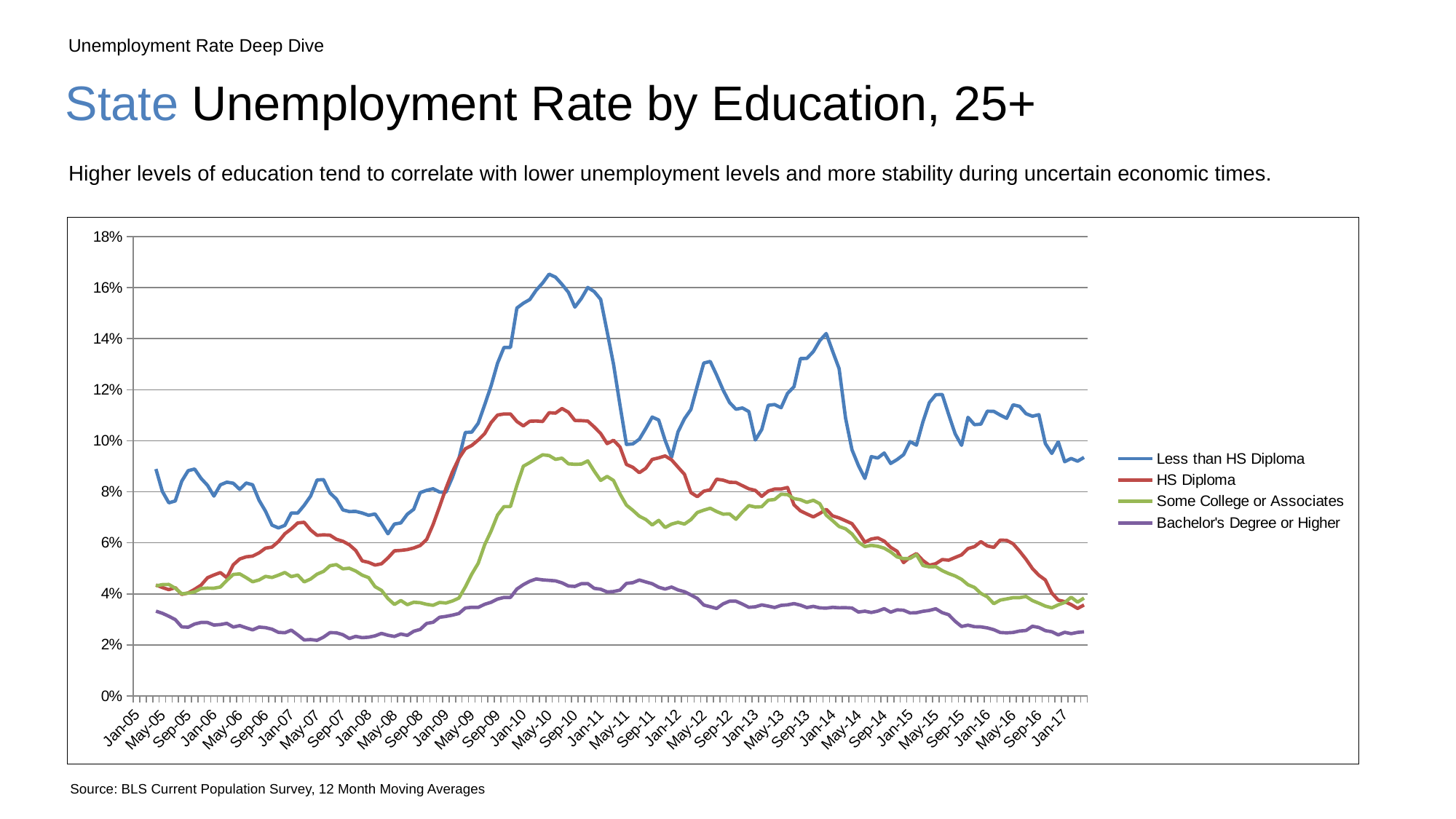
Is the peak value for Less than HS Diploma greater or less than 16%? greater Which education group has the lowest unemployment rate across the whole period? Bachelor's Degree or Higher Around Jan-14, which is higher: Less than HS Diploma or HS Diploma? Less than HS Diploma How many series does the legend list? 4 Is the highest value reached by Bachelor's Degree or Higher greater or less than 6%? less Between Jan-08 and May-10, does the Less than HS Diploma line rise or fall? rise Which series is drawn in purple? Bachelor's Degree or Higher Around Jan-17, is the value for Some College or Associates greater or less than 6%? less What kind of chart is shown on the slide? line chart Between May-13 and Jan-17, does the HS Diploma line rise or fall overall? fall Which education group has the highest unemployment rate across the whole period? Less than HS Diploma